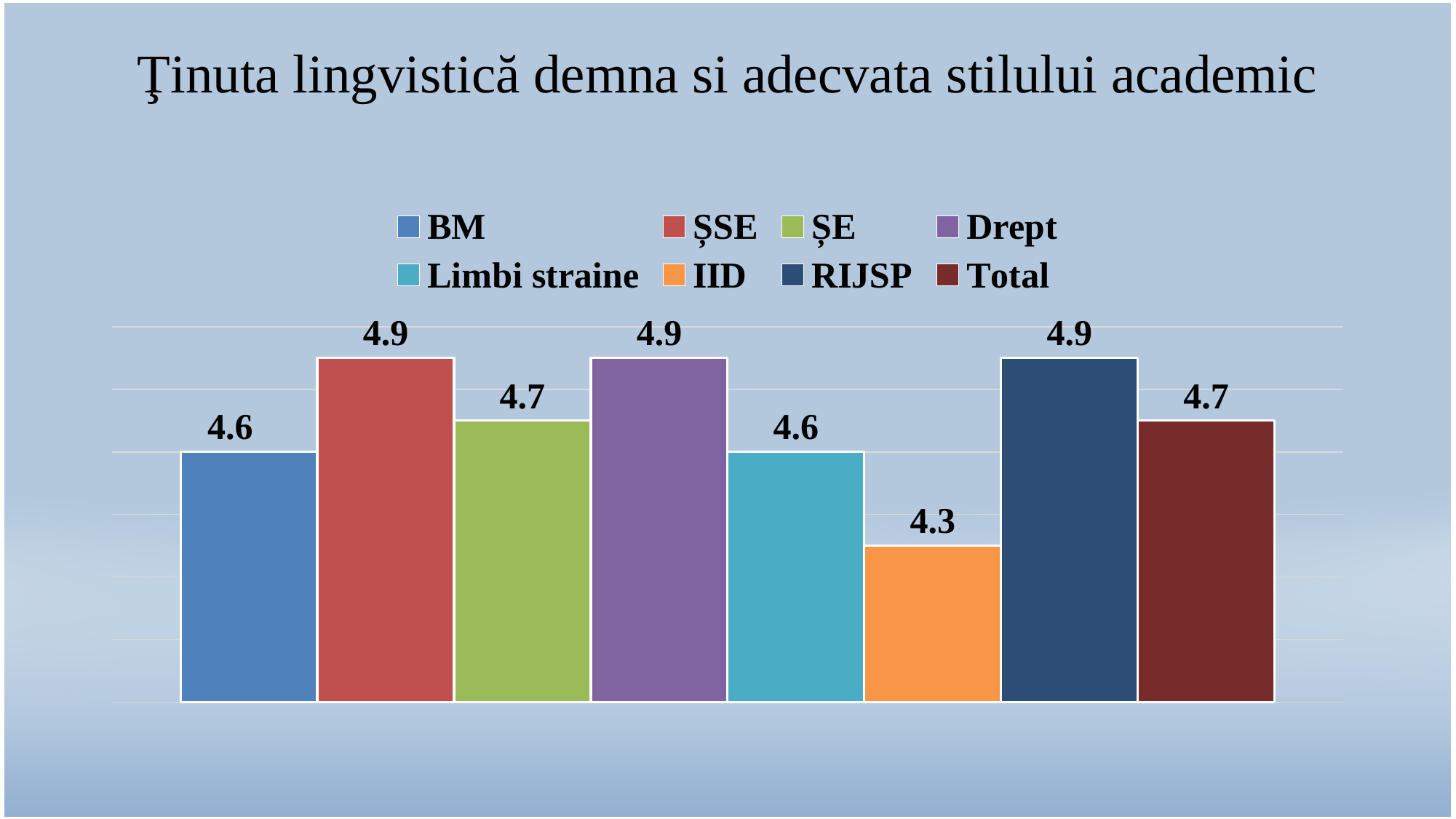
What is the value for Drept? 4.9 What is the difference between the values for Total and BM? 0.1 What is the difference between the values for ȘSE and IID? 0.6 What is the value for BM? 4.6 Which is larger, the value for ȘE or the value for Limbi straine? ȘE What is the value for Limbi straine? 4.6 What is the value for IID? 4.3 Which category has the lowest value? IID How many bars are plotted in the chart? 8 What is the value for Total? 4.7 How many entries does the legend list? 8 What kind of chart is shown on the slide? Bar chart